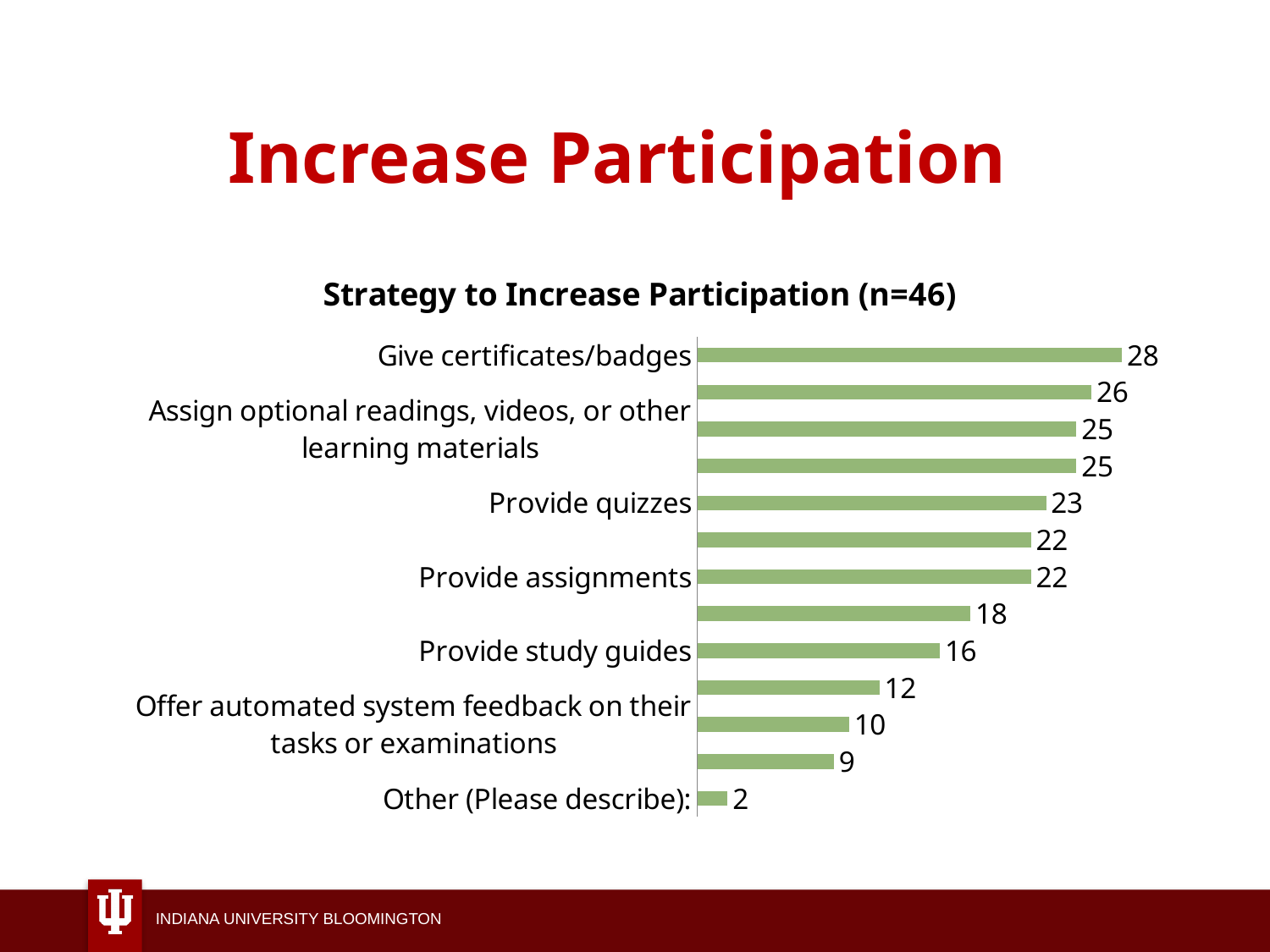
What is the value for Give certificates/badges? 28 What is the value for Other (Please describe):? 2 How many bars are plotted in the chart? 13 Which strategy has the highest value? Give certificates/badges Which is larger, the value for Provide assignments or the value for Provide study guides? Provide assignments What is the title of the chart? Strategy to Increase Participation (n=46) Which category has the lowest value? Other (Please describe): What is the value for Provide assignments? 22 What is the value for Provide quizzes? 23 What is the difference between the values for Give certificates/badges and Other (Please describe):? 26 What is the value for Provide study guides? 16 What is the difference between the values for Provide quizzes and Provide study guides? 7